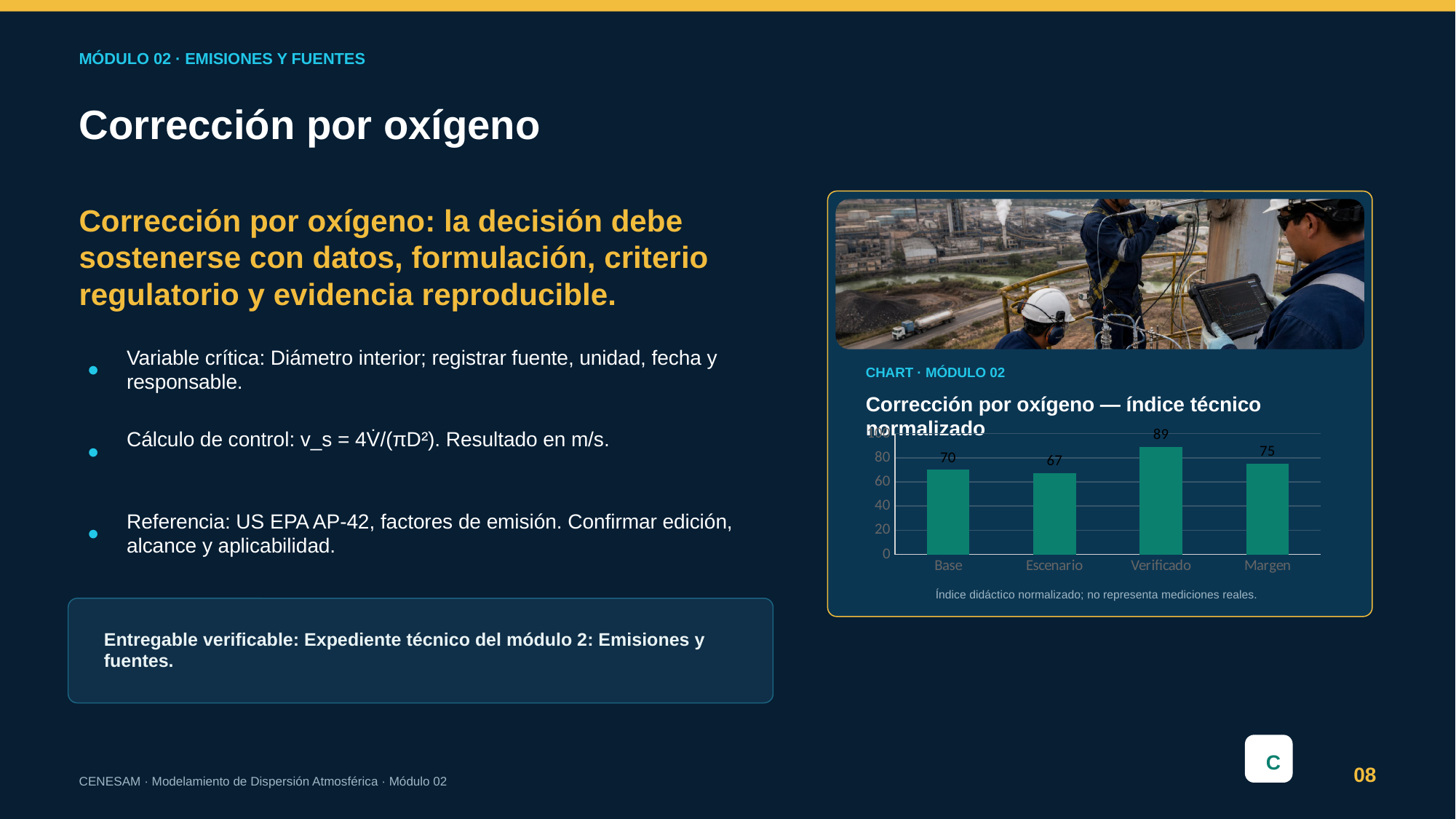
What is the title of the chart? Corrección por oxígeno — índice técnico normalizado What is the value for Verificado? 89 Is the value for Verificado greater or less than 80? greater Which is larger, the value for Margen or the value for Base? Margen What is the value for Margen? 75 What is the value for Base? 70 What is the difference between the values for Verificado and Escenario? 22 Which category has the highest value? Verificado Which category has the lowest value? Escenario What kind of chart is shown on the slide? Bar chart How many categories are shown on the x axis? 4 What is the value for Escenario? 67